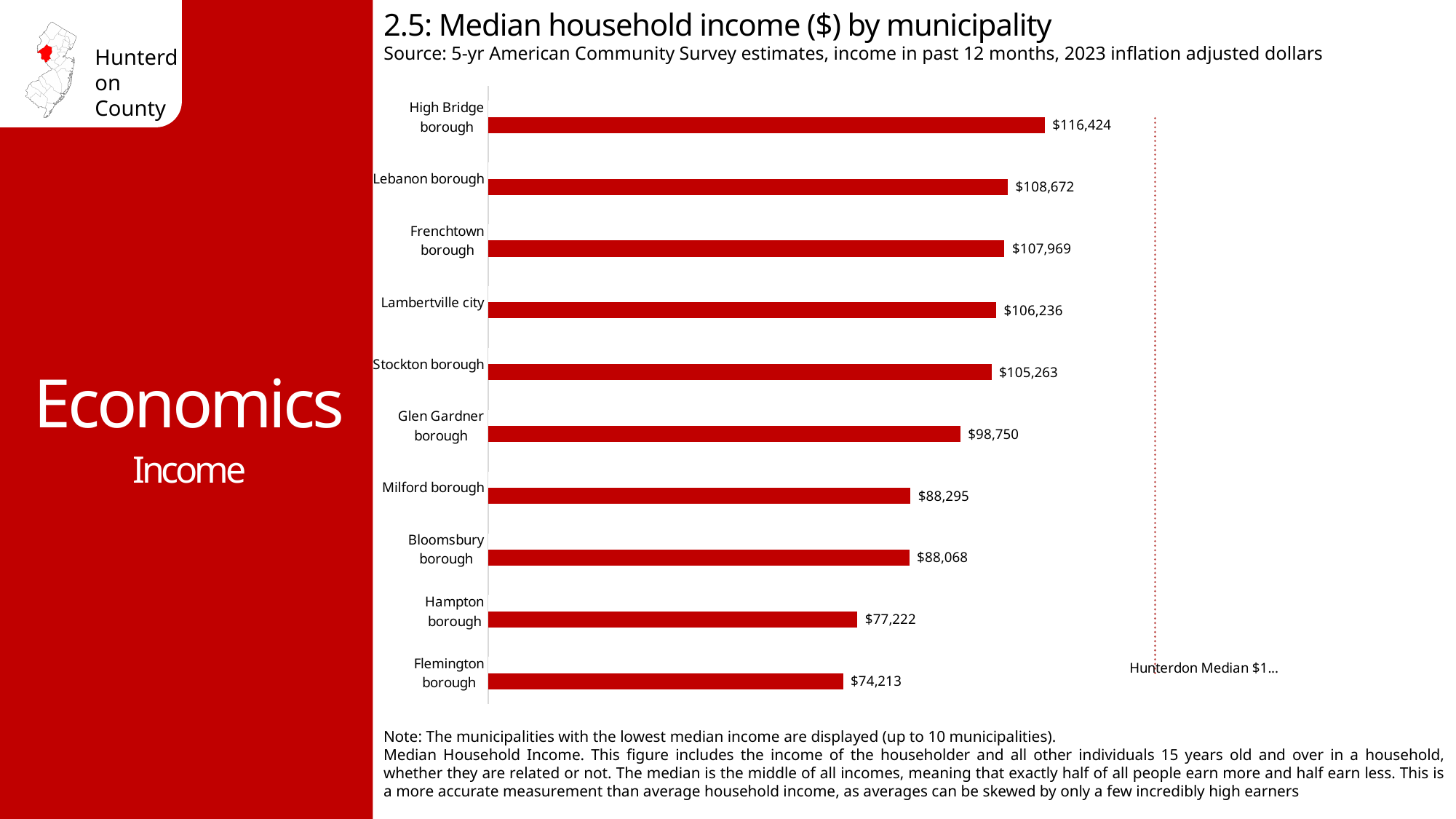
Which municipality has the lowest median household income shown on the chart? Flemington borough What is the difference between the median household income of Milford borough and Bloomsbury borough? $227 What is the difference between the median household income of High Bridge borough and Flemington borough? $42,211 Which municipality has the highest median household income shown on the chart? High Bridge borough What is the median household income for Lambertville city? $106,236 What is the median household income for Flemington borough? $74,213 What type of chart is used to show median household income by municipality? Bar chart What is the median household income for High Bridge borough? $116,424 How many municipalities are shown on the chart? 10 What is the median household income for Glen Gardner borough? $98,750 What is the title of the chart? 2.5: Median household income ($) by municipality Which has a higher median household income, Hampton borough or Stockton borough? Stockton borough